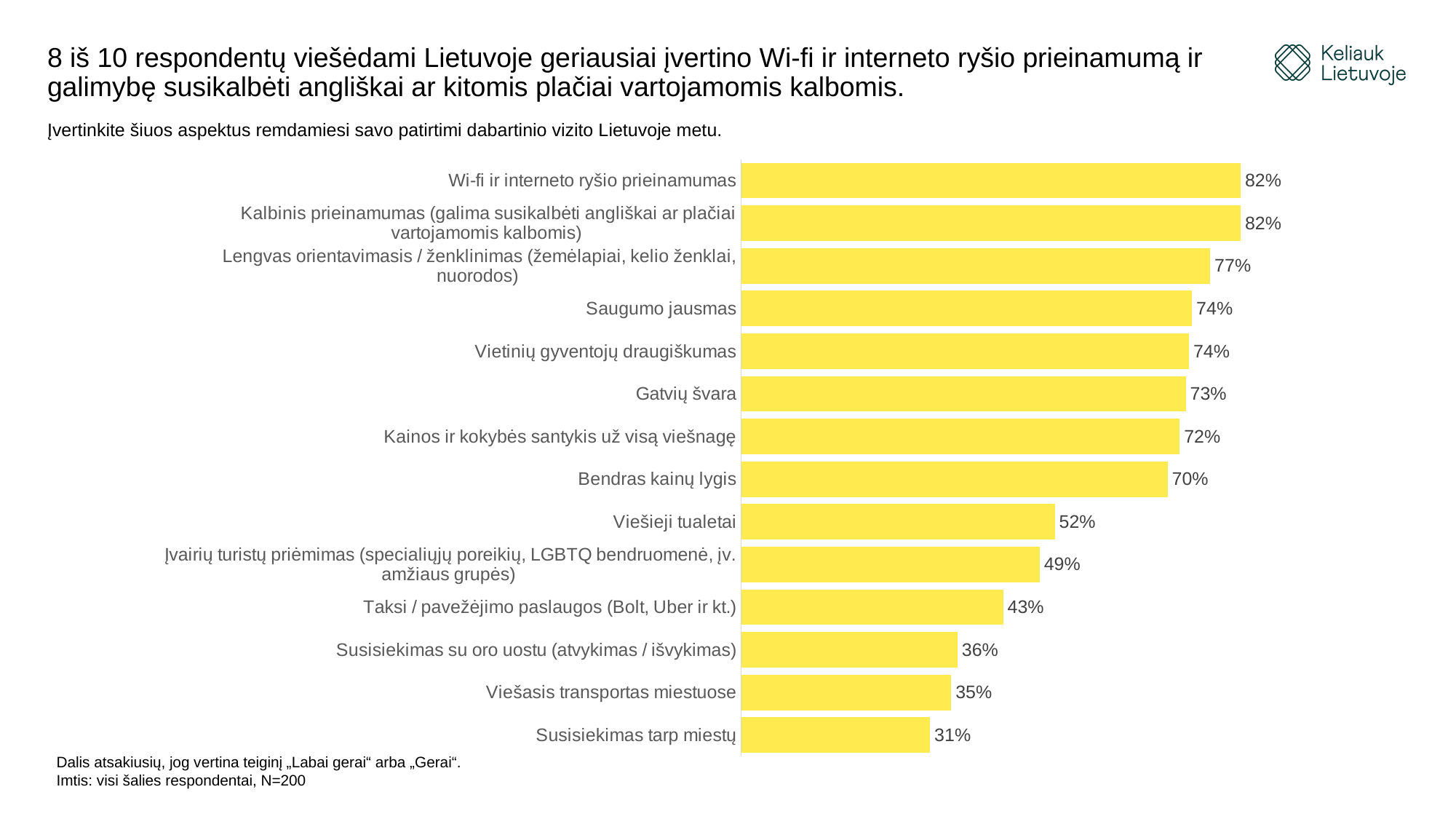
Which is larger: the value for "Taksi / pavežėjimo paslaugos (Bolt, Uber ir kt.)" or the value for "Viešasis transportas miestuose"? Taksi / pavežėjimo paslaugos (Bolt, Uber ir kt.) What kind of chart is shown on the slide? Bar chart What is the value for "Susisiekimas su oro uostu (atvykimas / išvykimas)"? 36% What is the value for "Wi-fi ir interneto ryšio prieinamumas"? 82% Which category has the lowest value in the chart? Susisiekimas tarp miestų What is the difference between the value for "Wi-fi ir interneto ryšio prieinamumas" and the value for "Susisiekimas tarp miestų"? 51 percentage points What is the value for "Viešieji tualetai"? 52% What colour are the bars in the chart? Yellow What is the value for "Saugumo jausmas"? 74% How many categories (aspects) are plotted in the chart? 14 What is the difference between the value for "Bendras kainų lygis" and the value for "Viešieji tualetai"? 18 percentage points Do the bar values increase or decrease going from the top of the chart to the bottom? Decrease